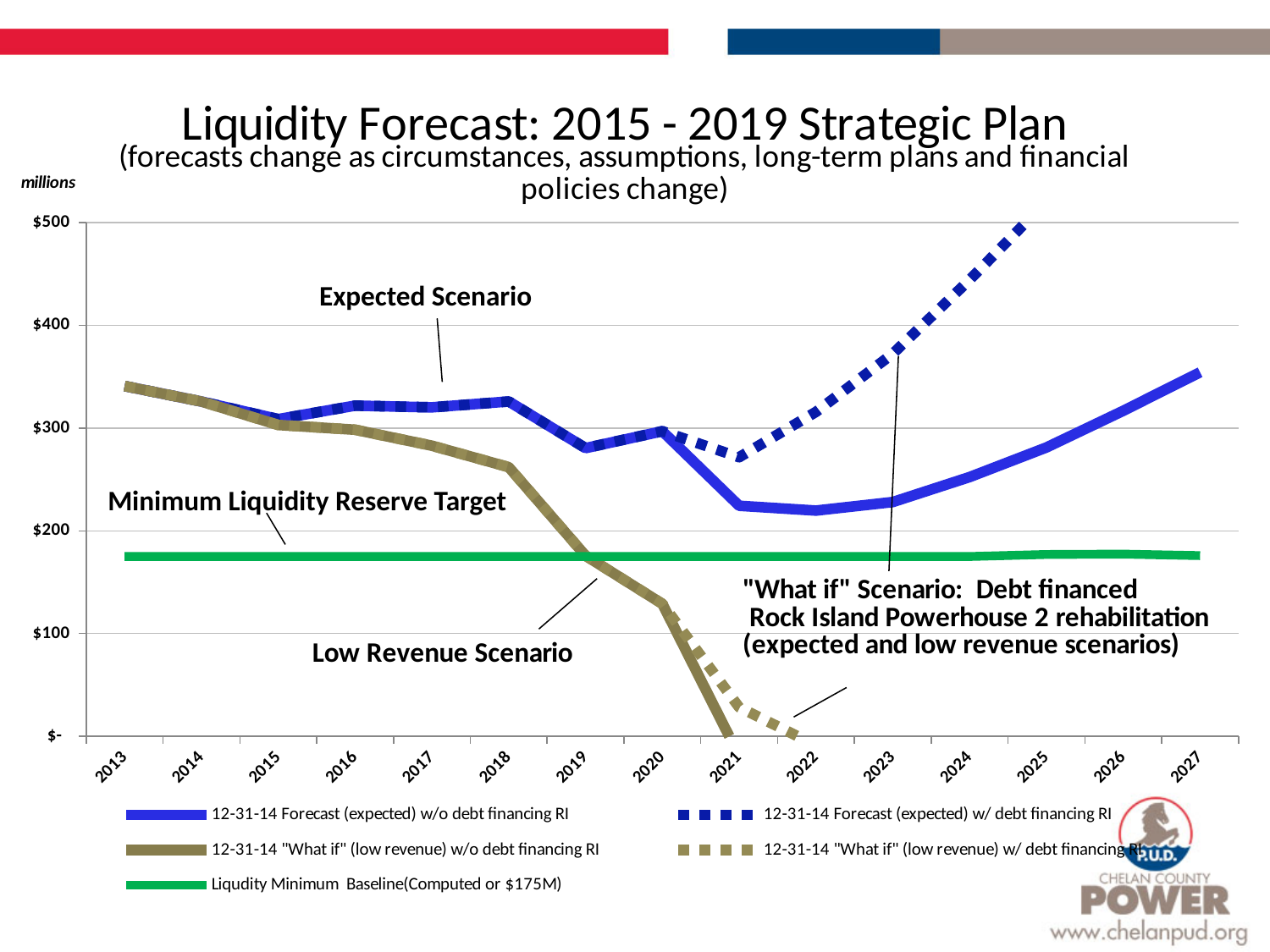
Is the value for the 12-31-14 "What if" (low revenue) w/o debt financing RI series in 2018 greater or less than $200? greater Which legend entry is drawn as a solid green line? Liqudity Minimum Baseline(Computed or $175M) What kind of chart is shown on the slide? Line chart Does the 12-31-14 Forecast (expected) w/o debt financing RI series rise or fall from 2022 to 2027? rise How many years are shown along the x axis? 15 Does the 12-31-14 "What if" (low revenue) w/o debt financing RI series rise or fall from 2013 to 2021? fall What is the title of the chart? Liquidity Forecast: 2015 - 2019 Strategic Plan Is the value for the 12-31-14 Forecast (expected) w/ debt financing RI series in 2024 greater or less than $400? greater Is the value for the 12-31-14 Forecast (expected) w/o debt financing RI series in 2021 greater or less than $300? less In 2021, which is higher: the 12-31-14 Forecast (expected) w/o debt financing RI or the 12-31-14 Forecast (expected) w/ debt financing RI? 12-31-14 Forecast (expected) w/ debt financing RI How many series does the legend list? 5